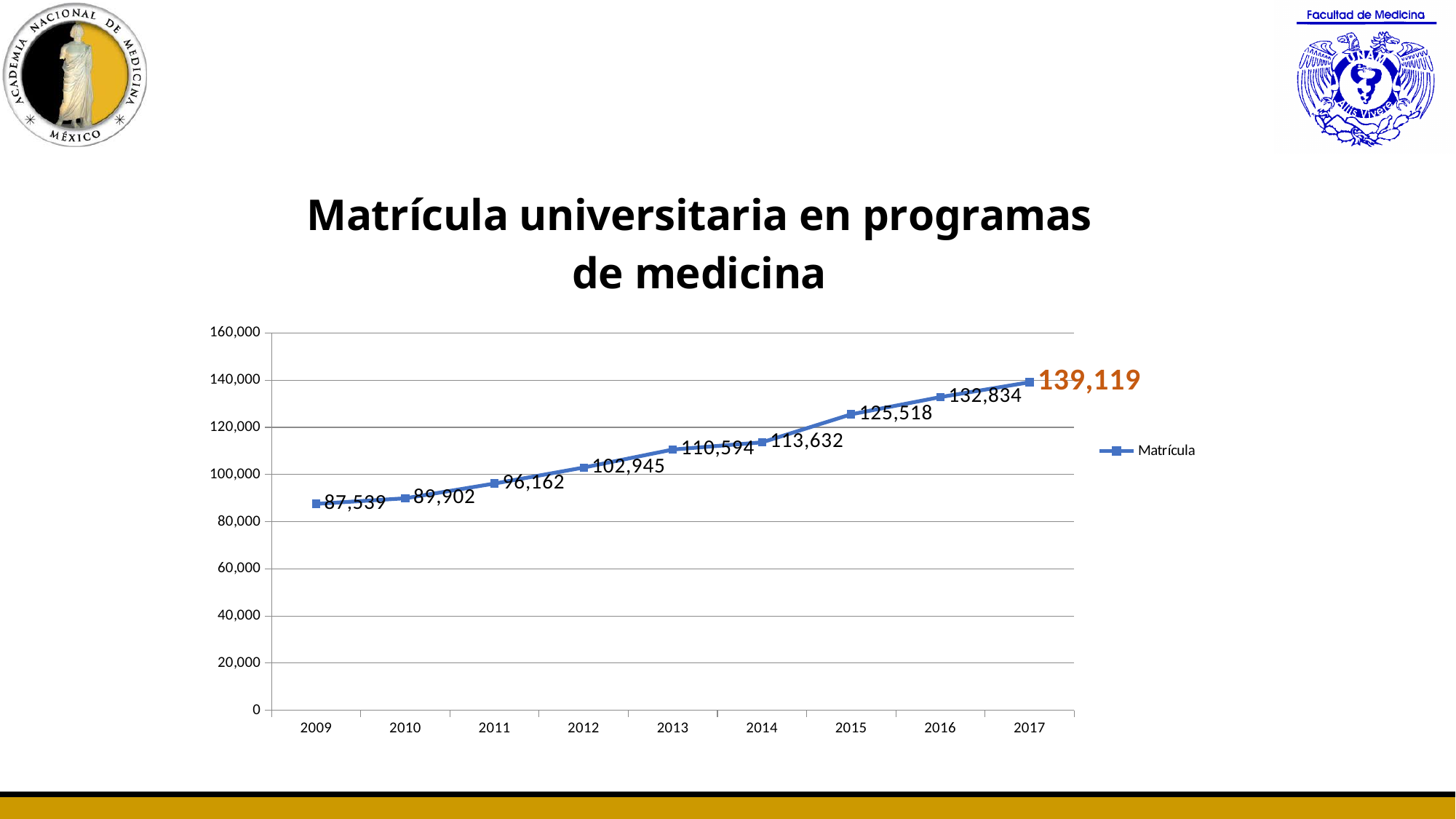
Which year has a larger Matrícula value, 2012 or 2016? 2016 What is the difference between the Matrícula values for 2017 and 2009? 51,580 What was the Matrícula value in 2013? 110,594 Which year has the highest Matrícula value? 2017 What is the difference between the Matrícula values for 2015 and 2014? 11,886 What was the Matrícula value in 2017? 139,119 How many years are plotted on the x axis? 9 What was the Matrícula value in 2009? 87,539 Do the Matrícula values rise or fall from 2009 to 2017? rise What kind of chart is shown on the slide? line chart Which year has the lowest Matrícula value? 2009 Is the Matrícula value for 2011 greater or less than 100,000? less